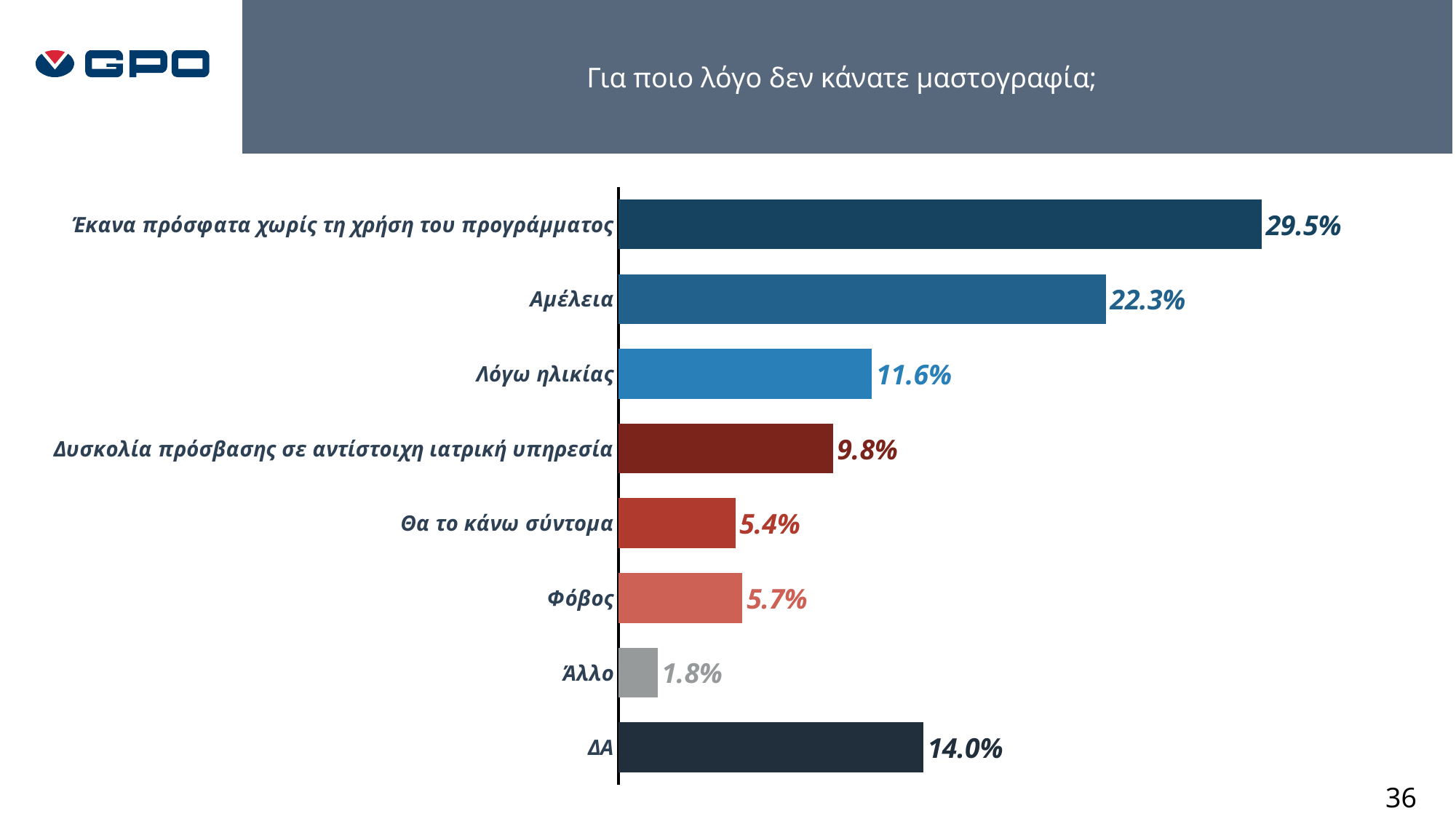
What is the value for ΔΑ? 14.0% What is the title of the chart? Για ποιο λόγο δεν κάνατε μαστογραφία; Which category has the lowest value? Άλλο What is the value for Λόγω ηλικίας? 11.6% What is the difference between the values for ΔΑ and Δυσκολία πρόσβασης σε αντίστοιχη ιατρική υπηρεσία? 4.2% Which category has the highest value? Έκανα πρόσφατα χωρίς τη χρήση του προγράμματος Which is larger, the value for Λόγω ηλικίας or the value for ΔΑ? ΔΑ What is the value for Αμέλεια? 22.3% What kind of chart is shown on the slide? Bar chart What is the value for Φόβος? 5.7% What is the difference between the values for Έκανα πρόσφατα χωρίς τη χρήση του προγράμματος and Αμέλεια? 7.2% How many categories are shown in the chart? 8